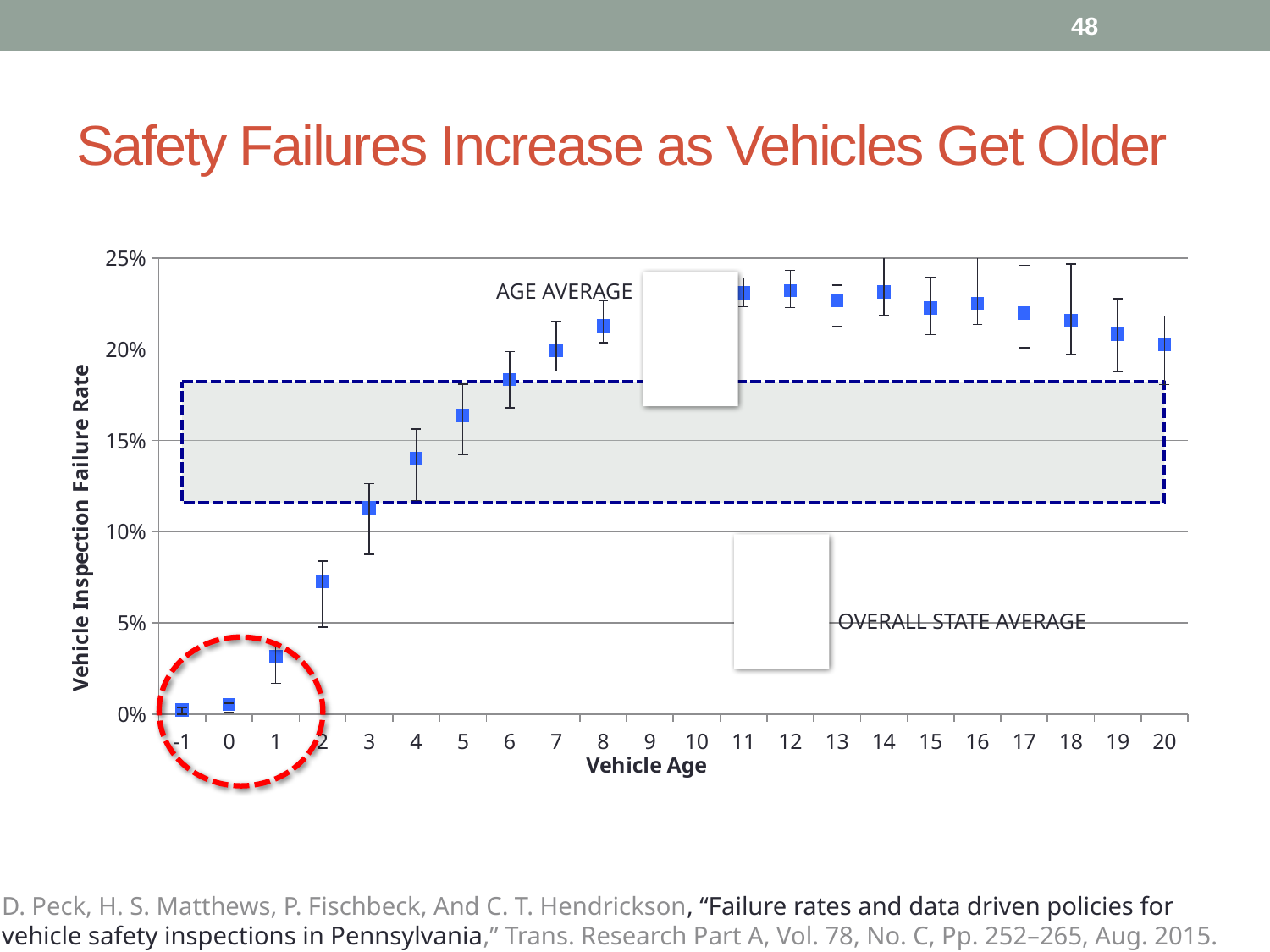
Is the failure rate for vehicle age 12 greater or less than 20%? greater Between vehicle age 0 and vehicle age 8, do the failure rates rise or fall? Rise What is the title of the chart on the slide? Safety Failures Increase as Vehicles Get Older Is the failure rate for vehicle age 1 greater or less than 5%? less What kind of chart is shown on the slide? Scatter (point) chart with error bars Is the failure rate for vehicle age 6 greater or less than 20%? less Which has the higher failure rate, vehicle age 3 or vehicle age 7? Vehicle age 7 What is the label of the vertical axis? Vehicle Inspection Failure Rate How many vehicle age values are plotted along the x axis? 22